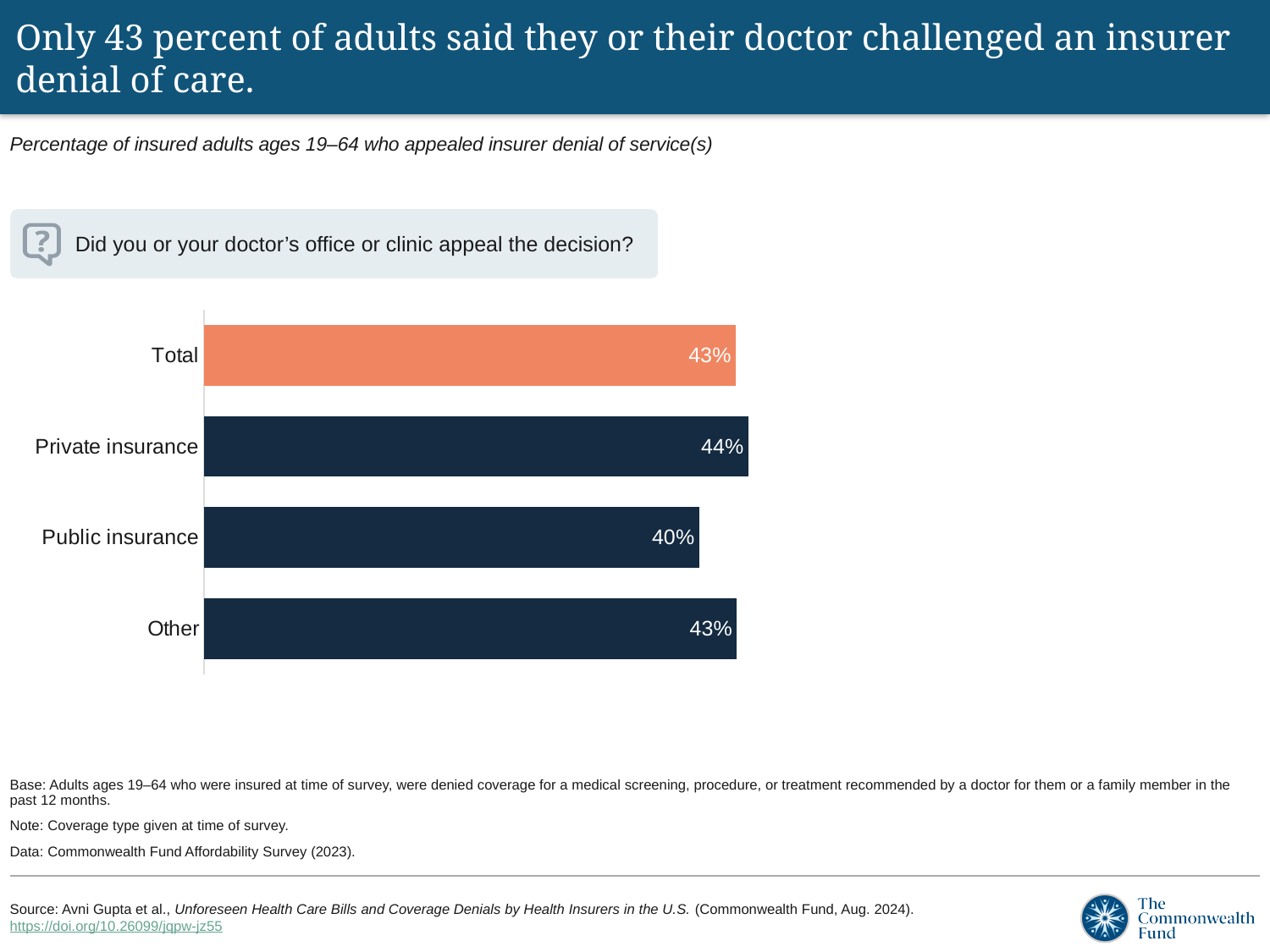
Which category has the lowest percentage? Public insurance What percentage is shown for Private insurance? 44% What kind of chart is shown on the slide? Bar chart What percentage is shown for Total? 43% Which is larger, the value for Private insurance or the value for Public insurance? Private insurance What percentage is shown for Other? 43% Which category has the highest percentage? Private insurance Which bar is shown in a different colour (orange) from the others? Total How many categories are shown in the chart? 4 What percentage is shown for Public insurance? 40% What survey question is shown above the chart? Did you or your doctor's office or clinic appeal the decision? What is the difference in percentage points between Private insurance and Public insurance? 4